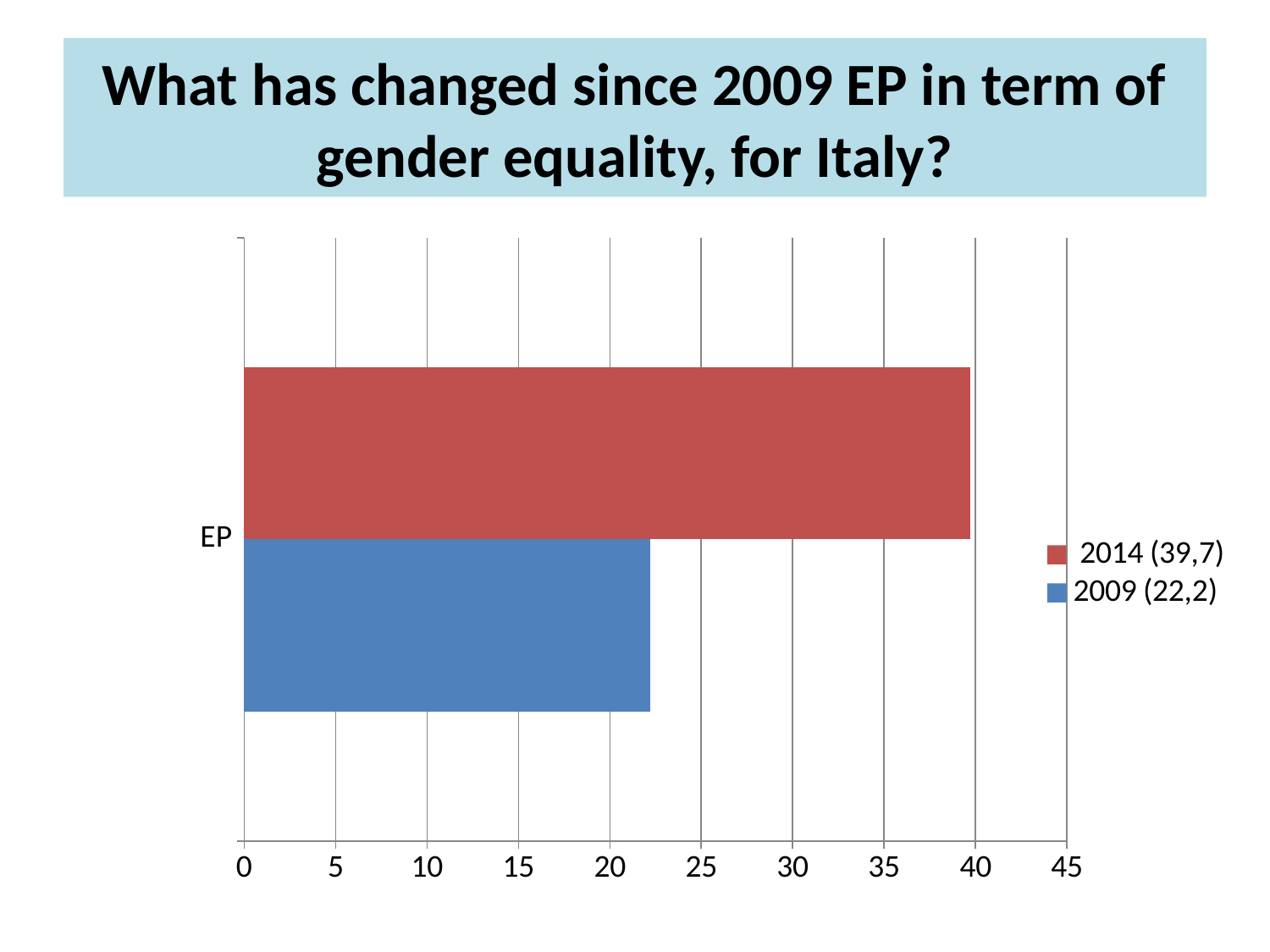
Which series has the higher value for EP, 2014 or 2009? 2014 Which series has the lowest value on the chart? 2009 Is the value for the 2009 series greater or less than 25? less How many categories are plotted on the chart? 1 What is the difference between the 2014 value and the 2009 value for EP? 17,5 What colour is the bar for the 2009 series? blue What is the value for the 2014 series for EP? 39,7 Is the value for the 2014 series greater or less than 35? greater What kind of chart is shown on the slide? bar chart What is the value for the 2009 series for EP? 22,2 How many series does the legend list? 2 What is the label of the category on the vertical axis? EP